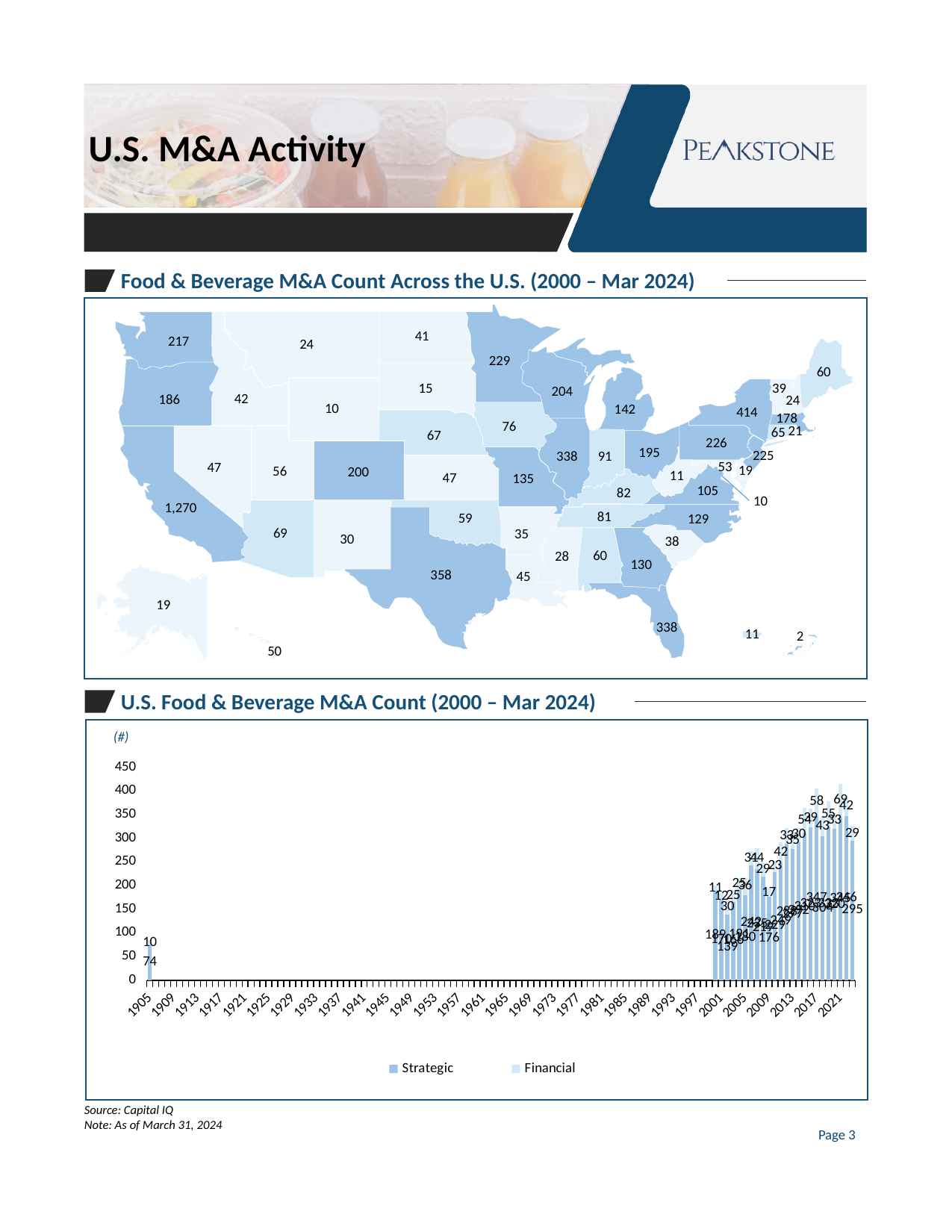
In the chart 'U.S. Food & Beverage M&A Count (2000 – Mar 2024)', what is the Strategic value for 1905? 74 In the chart 'U.S. Food & Beverage M&A Count (2000 – Mar 2024)', what is the total of the stacked bar for 1905? 84 On the map chart 'Food & Beverage M&A Count Across the U.S. (2000 – Mar 2024)', what is the difference between the values for California (1,270) and Texas (358)? 912 On the map chart 'Food & Beverage M&A Count Across the U.S. (2000 – Mar 2024)', what is the value shown for Texas? 358 How many series does the legend of 'U.S. Food & Beverage M&A Count (2000 – Mar 2024)' list? 2 In the chart 'U.S. Food & Beverage M&A Count (2000 – Mar 2024)', what is the Financial value for 1905? 10 On the map chart 'Food & Beverage M&A Count Across the U.S. (2000 – Mar 2024)', what is the value shown for Florida? 338 In the chart 'U.S. Food & Beverage M&A Count (2000 – Mar 2024)', what are the two series named in the legend? Strategic and Financial On the map chart 'Food & Beverage M&A Count Across the U.S. (2000 – Mar 2024)', which has a larger value, California or Texas? California On the map chart 'Food & Beverage M&A Count Across the U.S. (2000 – Mar 2024)', what is the highest value shown? 1,270 On the map chart 'Food & Beverage M&A Count Across the U.S. (2000 – Mar 2024)', what is the lowest value shown? 2 What kind of chart is 'U.S. Food & Beverage M&A Count (2000 – Mar 2024)'? Stacked bar chart